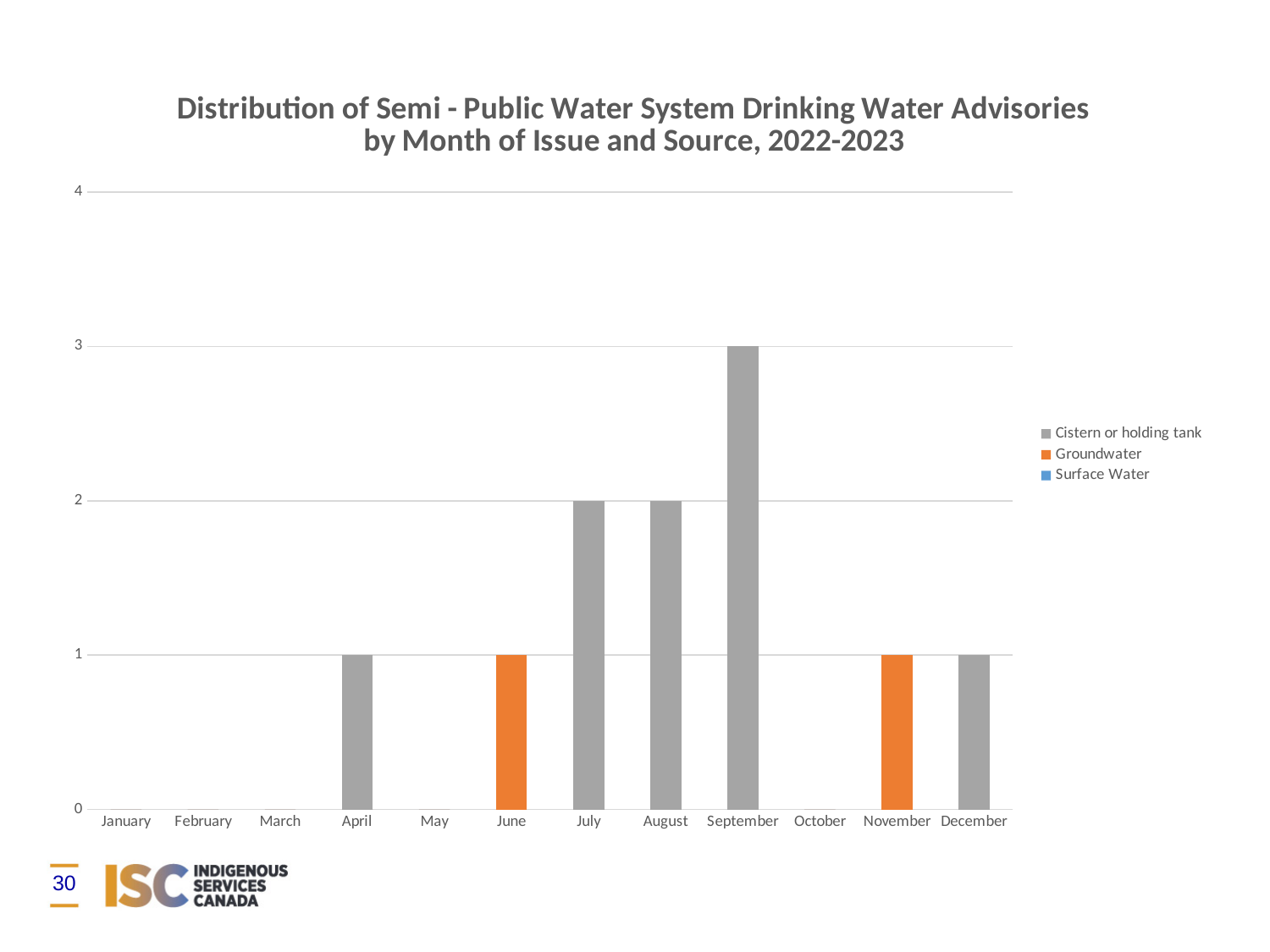
What is the value for Cistern or holding tank in September? 3 Which month has the highest number of advisories? September What is the value for Cistern or holding tank in April? 1 Which is larger, the value for July or the value for December? July In which months does the Groundwater series have a bar? June and November What type of chart is shown on the slide? bar chart Which source does the orange colour represent in the legend? Groundwater What is the difference between the September and August values for Cistern or holding tank? 1 How many months are shown along the x axis? 12 How many series does the legend list? 3 What is the value for Cistern or holding tank in July? 2 What is the value for Groundwater in November? 1